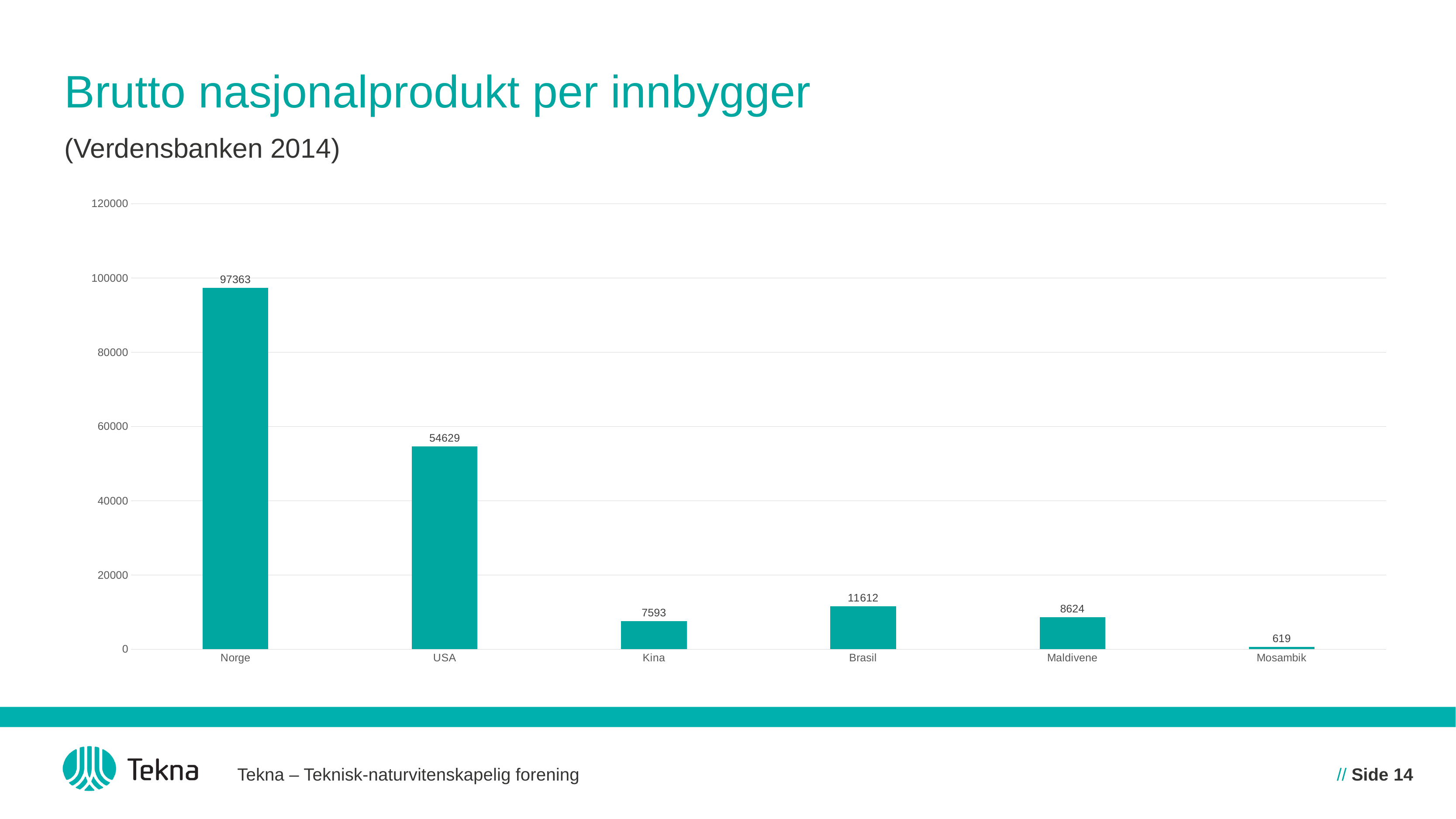
How many countries are shown on the chart? 6 What kind of chart is shown on the slide? bar chart What is the value for Kina? 7593 Is the value for USA greater or less than 60000? less What is the difference between the values for Brasil and Maldivene? 2988 What is the value for Mosambik? 619 Which country has the highest value? Norge Which country has the lowest value? Mosambik What is the value for Norge? 97363 Which is larger, the value for Brasil or the value for Kina? Brasil What is the difference between the values for Norge and USA? 42734 What is the value for USA? 54629